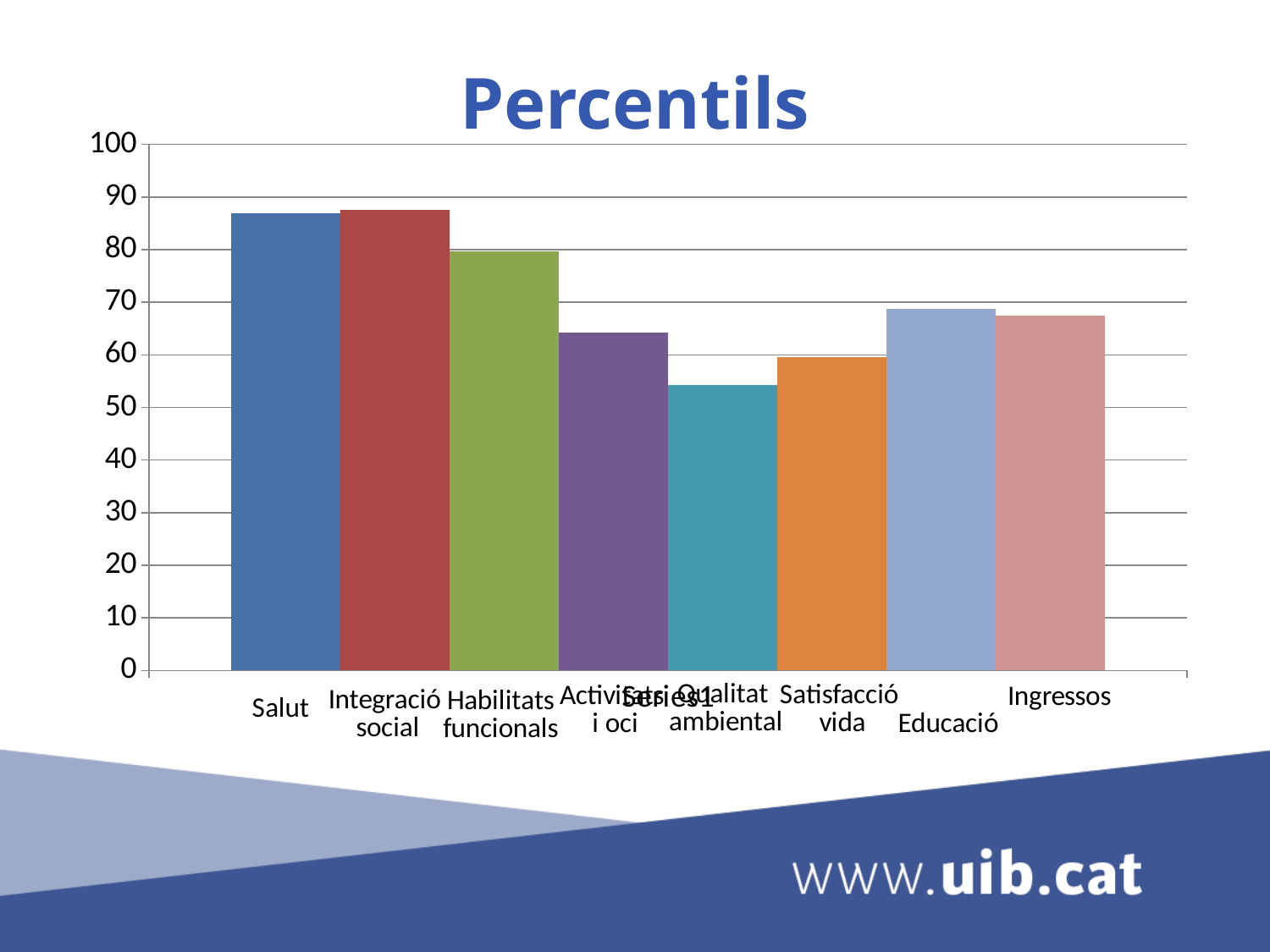
How many categories are plotted in the chart? 8 Which is larger, the value for Habilitats funcionals or the value for Satisfacció vida? Habilitats funcionals What is the title of the chart? Percentils Which category has the lowest value? Qualitat ambiental Is the value for Educació greater or less than 60? greater Which is larger, the value for Salut or the value for Activitats i oci? Salut Is the value for Activitats i oci greater or less than 60? greater Is the value for Salut greater or less than 80? greater What kind of chart is shown on the slide? bar chart What is the highest value shown on the vertical axis? 100